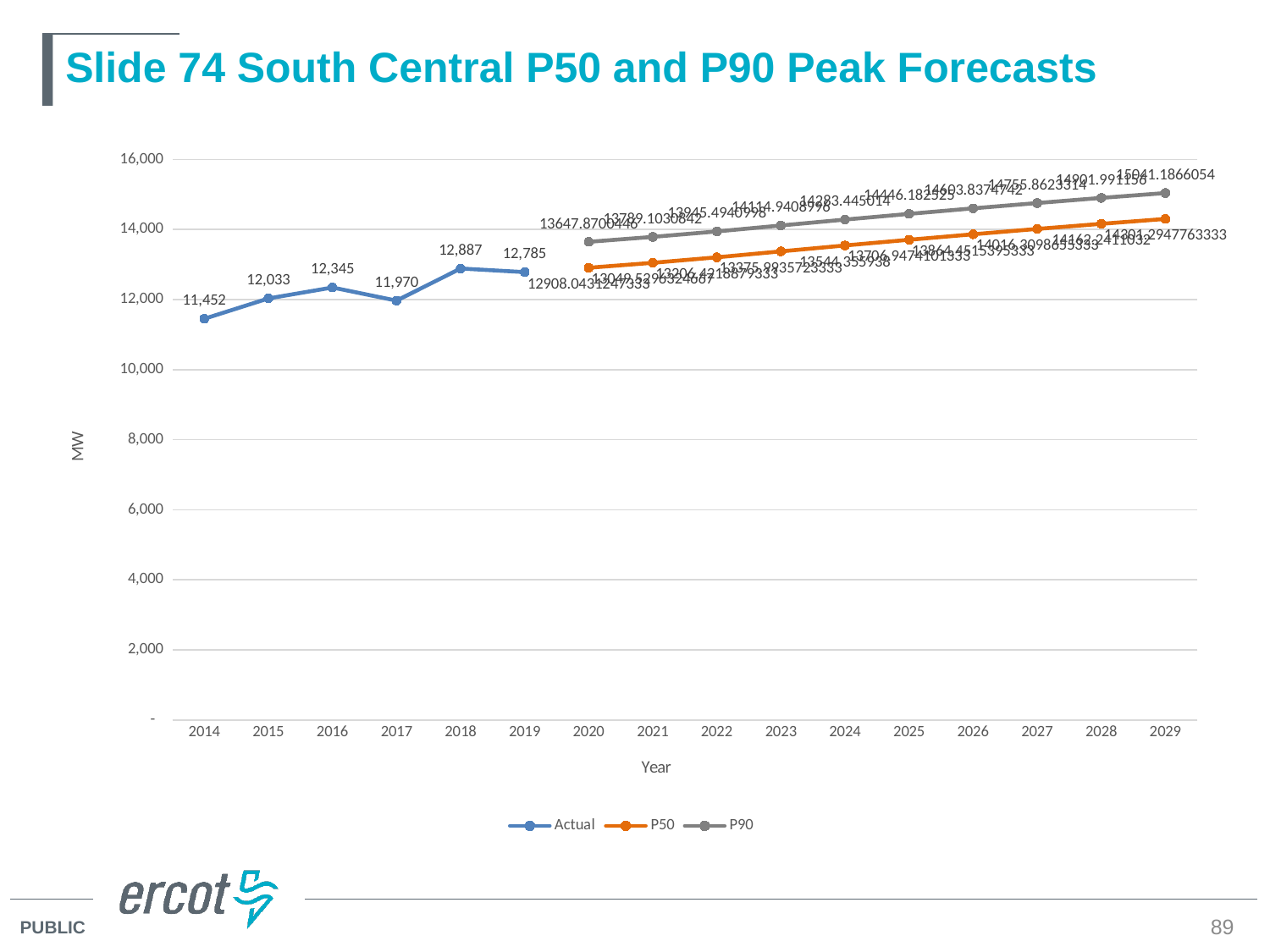
What is the Actual value for 2018? 12,887 What is the difference between the Actual values for 2018 and 2019? 102 Is the P90 value for 2029 greater or less than 14,000? greater In which year is the Actual series lowest? 2014 What is the Actual value for 2014? 11,452 Which year has the larger Actual value, 2016 or 2017? 2016 Is the P50 value for 2020 greater or less than 14,000? less What kind of chart is shown on the slide? line chart How many years are shown on the x axis? 16 In which year is the Actual series highest? 2018 How many series does the legend list? 3 Does the P90 series rise or fall from 2020 to 2029? rise